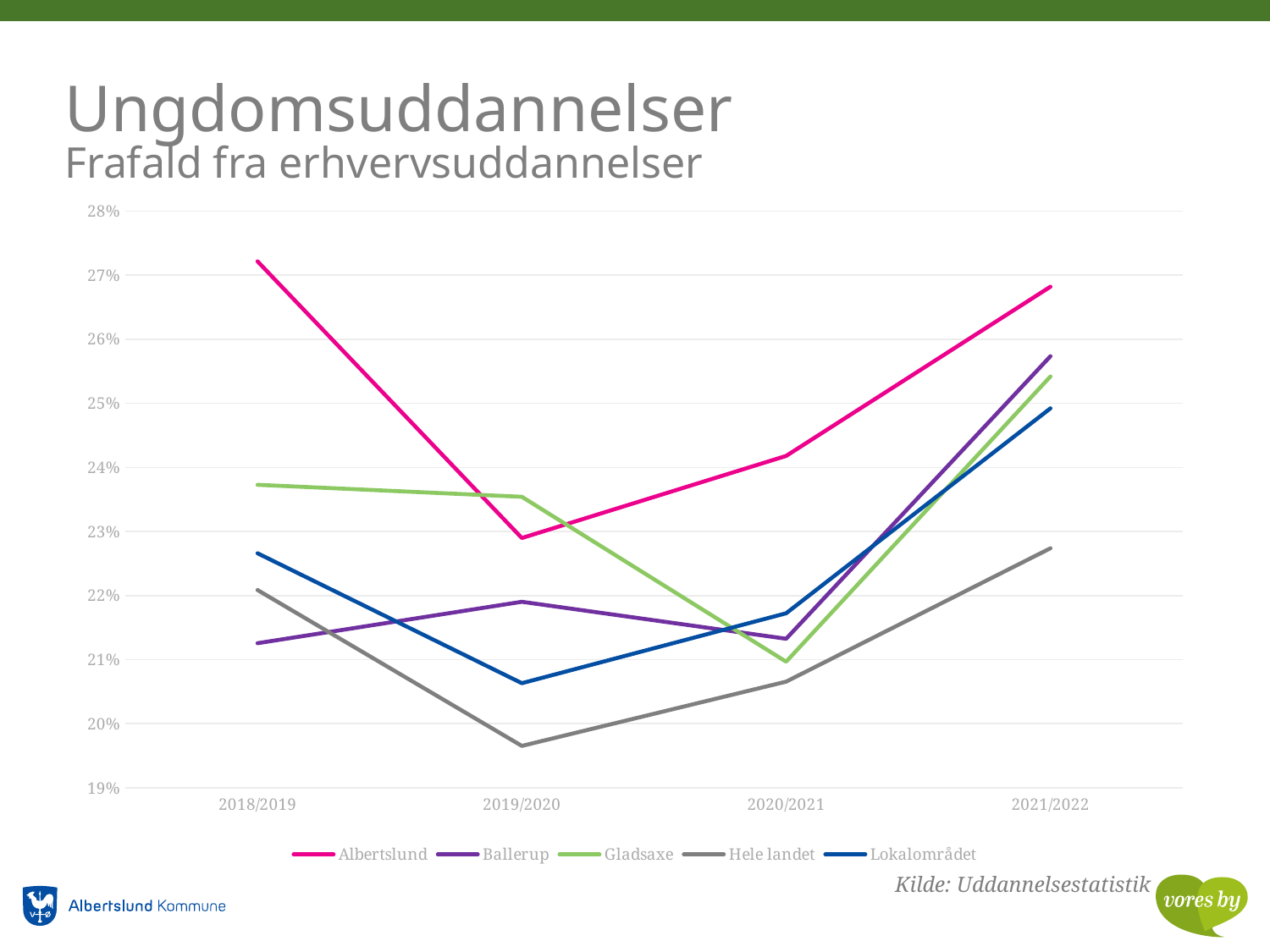
Is the value for Albertslund in 2018/2019 greater or less than 26%? greater How many school years are shown on the x axis? 4 In 2018/2019, which is larger: Gladsaxe or Ballerup? Gladsaxe Which series has the lowest value in 2019/2020? Hele landet Is the value for Hele landet in 2019/2020 greater or less than 20%? less What kind of chart is shown on the slide? Line chart Which series has the highest value in 2021/2022? Albertslund Is the value for Ballerup in 2021/2022 greater or less than 25%? greater How many series does the legend list? 5 What colour is the Albertslund line in the legend? Pink Does the Albertslund line rise or fall from 2018/2019 to 2019/2020? Falls Which series has the highest value in 2018/2019? Albertslund